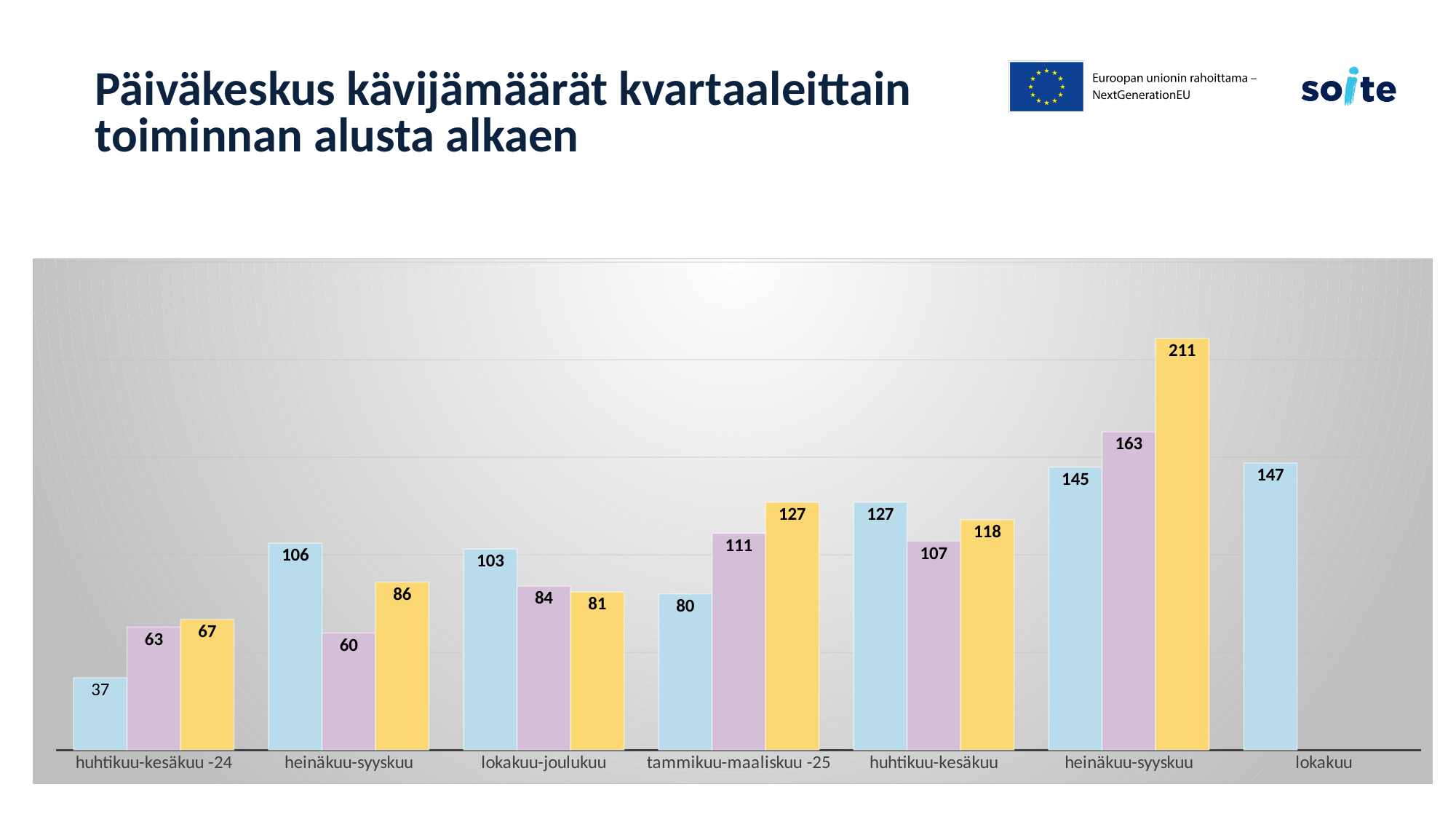
Which is larger in the lokakuu-joulukuu category: the light blue bar or the purple bar? the light blue bar (103) What is the value of the light blue bar for lokakuu? 147 Which bar in the chart has the lowest value? the light blue bar for huhtikuu-kesäkuu -24 (37) What is the total of the three bars for huhtikuu-kesäkuu -24? 167 What is the title of the slide containing the chart? Päiväkeskus kävijämäärät kvartaaleittain toiminnan alusta alkaen Which bar in the chart has the highest value? the yellow bar for heinäkuu-syyskuu (211) What kind of chart is shown on the slide? bar chart How many categories are shown on the x axis of the chart? 7 What is the value of the light blue bar for huhtikuu-kesäkuu -24? 37 What is the value of the yellow bar for heinäkuu-syyskuu (the second heinäkuu-syyskuu category, after huhtikuu-kesäkuu)? 211 What is the value of the purple bar for tammikuu-maaliskuu -25? 111 What is the difference between the yellow bar (211) and the purple bar (163) in the second heinäkuu-syyskuu category? 48